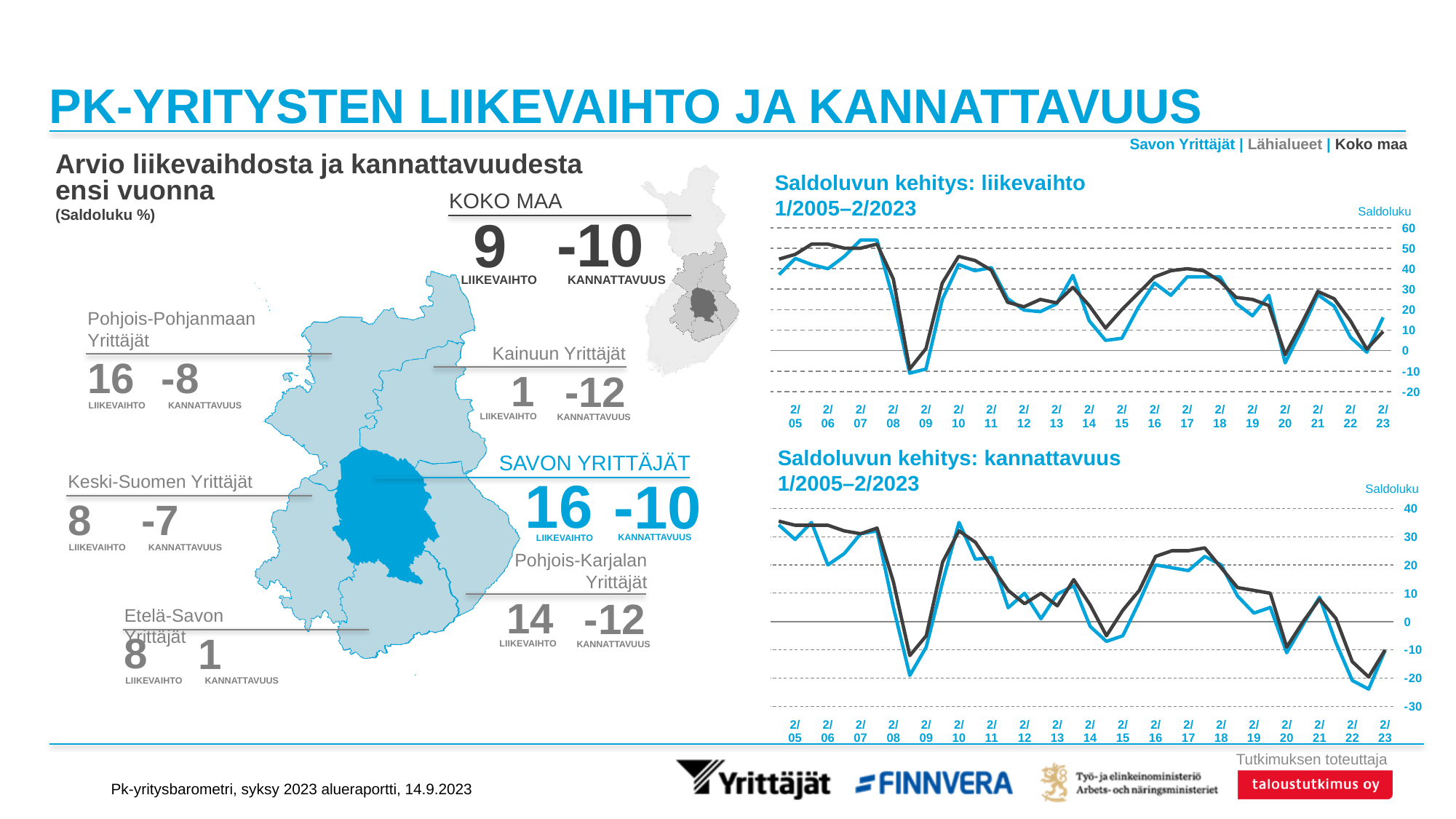
In the 'Saldoluvun kehitys: kannattavuus' chart, do the values overall rise or fall from 2/05 to 2/23? fall In the 'Saldoluvun kehitys: kannattavuus' chart, is the blue (Savon Yrittäjät) value at 2/10 greater or less than 30? greater What kind of chart is 'Saldoluvun kehitys: liikevaihto 1/2005–2/2023'? line chart In the 'Saldoluvun kehitys: liikevaihto' chart, how many time points are labelled on the x axis? 19 In the 'Saldoluvun kehitys: kannattavuus' chart, how many time points are labelled on the x axis? 19 In the 'Saldoluvun kehitys: liikevaihto' chart, is the blue (Savon Yrittäjät) value at 2/07 greater or less than 40? greater What kind of chart is 'Saldoluvun kehitys: kannattavuus 1/2005–2/2023'? line chart In the 'Saldoluvun kehitys: liikevaihto' chart, is the blue (Savon Yrittäjät) value at 2/08 greater or less than 0? greater What is the label shown on the y axis of the 'Saldoluvun kehitys: liikevaihto' chart? Saldoluku